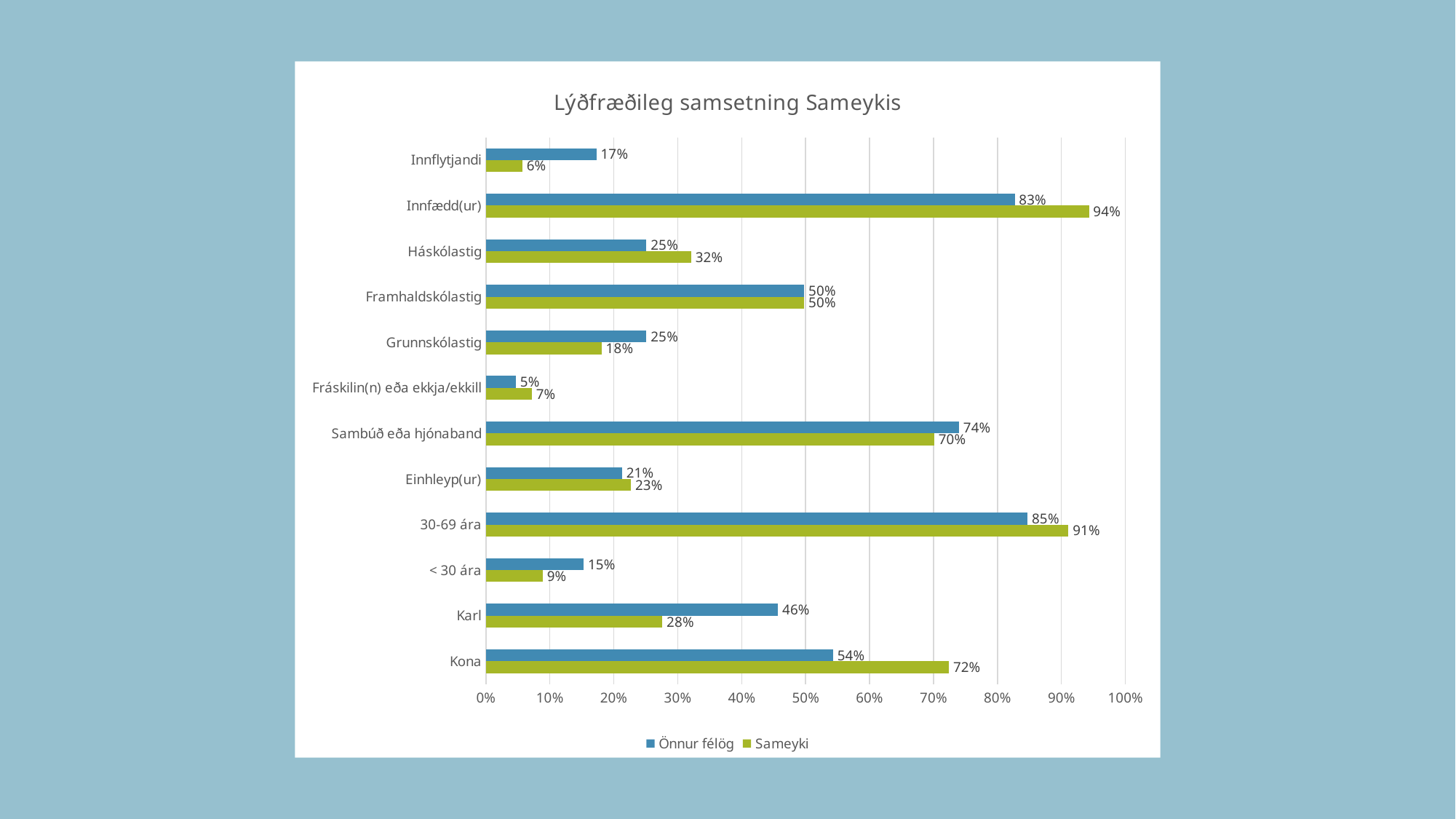
How many series does the legend list? 2 What is the Sameyki value for Innflytjandi? 6% What kind of chart is shown? Bar chart What is the title of the chart? Lýðfræðileg samsetning Sameykis What is the difference between the Sameyki and Önnur félög values for Kona? 18% Which category has the highest Sameyki value? Innfædd(ur) What is the Önnur félög value for Karl? 46% Is the Önnur félög value for Sambúð eða hjónaband greater or less than 70%? greater Which is larger for 30-69 ára: the Önnur félög value or the Sameyki value? Sameyki How many categories are shown on the y axis? 12 What is the Sameyki value for Kona? 72% Which category has the lowest Önnur félög value? Fráskilin(n) eða ekkja/ekkill